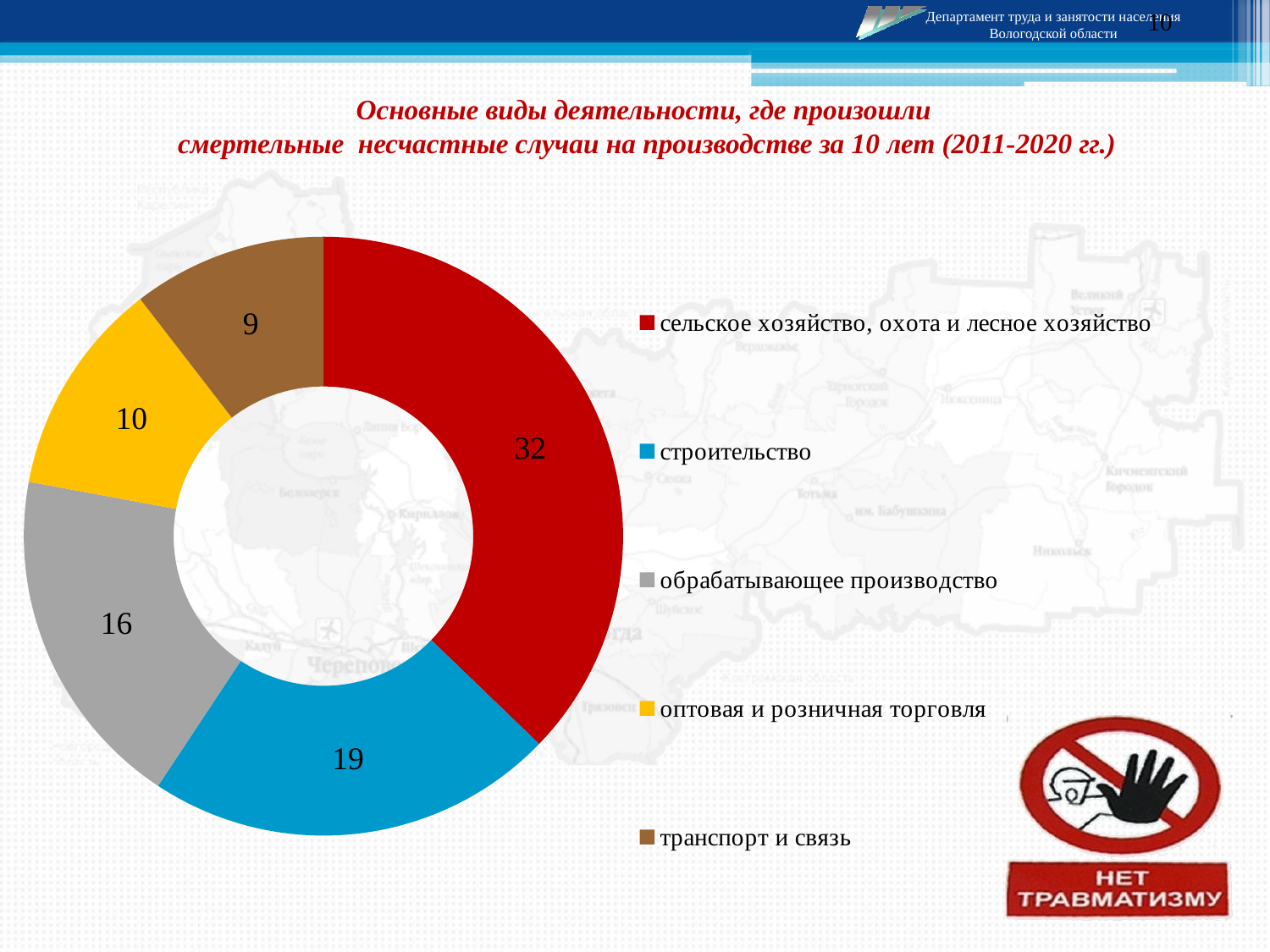
What value is shown for обрабатывающее производство? 16 What value is shown for оптовая и розничная торговля? 10 Which category has the smallest value? транспорт и связь What colour is the segment for строительство? blue How many categories are shown in the chart? 5 Which category has the largest value? сельское хозяйство, охота и лесное хозяйство What value is shown for строительство? 19 What kind of chart is shown on the slide? pie chart (doughnut) What value is shown for сельское хозяйство, охота и лесное хозяйство? 32 What value is shown for транспорт и связь? 9 What is the difference between the values for сельское хозяйство, охота и лесное хозяйство and строительство? 13 Which is larger: the value for обрабатывающее производство or the value for оптовая и розничная торговля? обрабатывающее производство